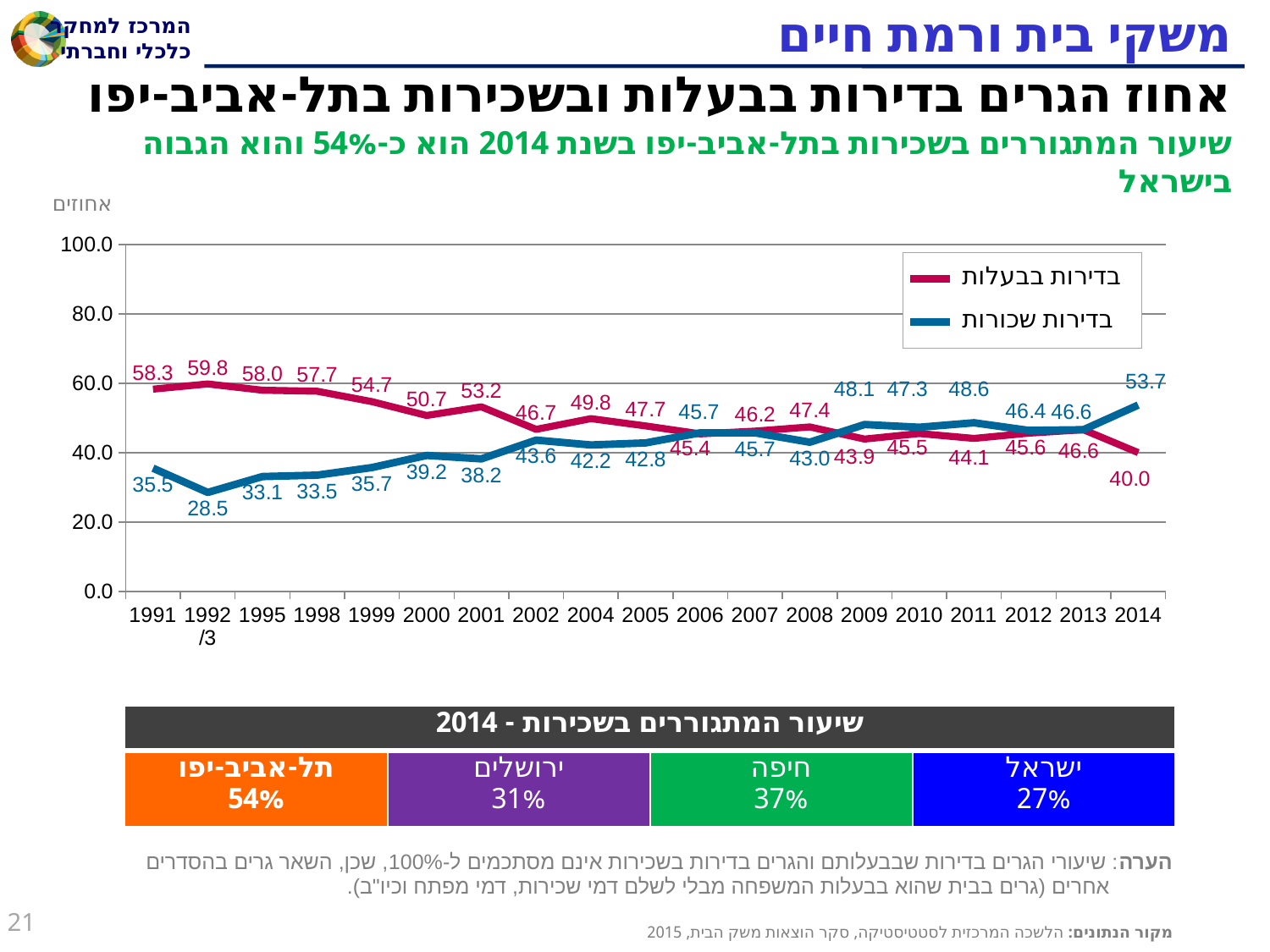
How many series does the chart legend list? 2 What is the difference between the בדירות בבעלות value in 1991 (58.3) and in 2014 (40.0)? 18.3 In 2014, which series has the larger value, בדירות בבעלות or בדירות שכורות? בדירות שכורות What is the value of the בדירות בבעלות series in 2000? 50.7 In which year does the בדירות שכורות series have its lowest value? 1992/3 What type of chart is shown on the slide? line chart What is the value of the בדירות שכורות series in 2014? 53.7 How many years are shown on the x axis of the chart? 19 Does the בדירות בבעלות series generally rise or fall from 1991 to 2014? fall What is the value of the בדירות בבעלות series in 1991? 58.3 What is the value of the בדירות שכורות series in 1992/3? 28.5 In which year does the בדירות בבעלות series reach its highest value? 1992/3